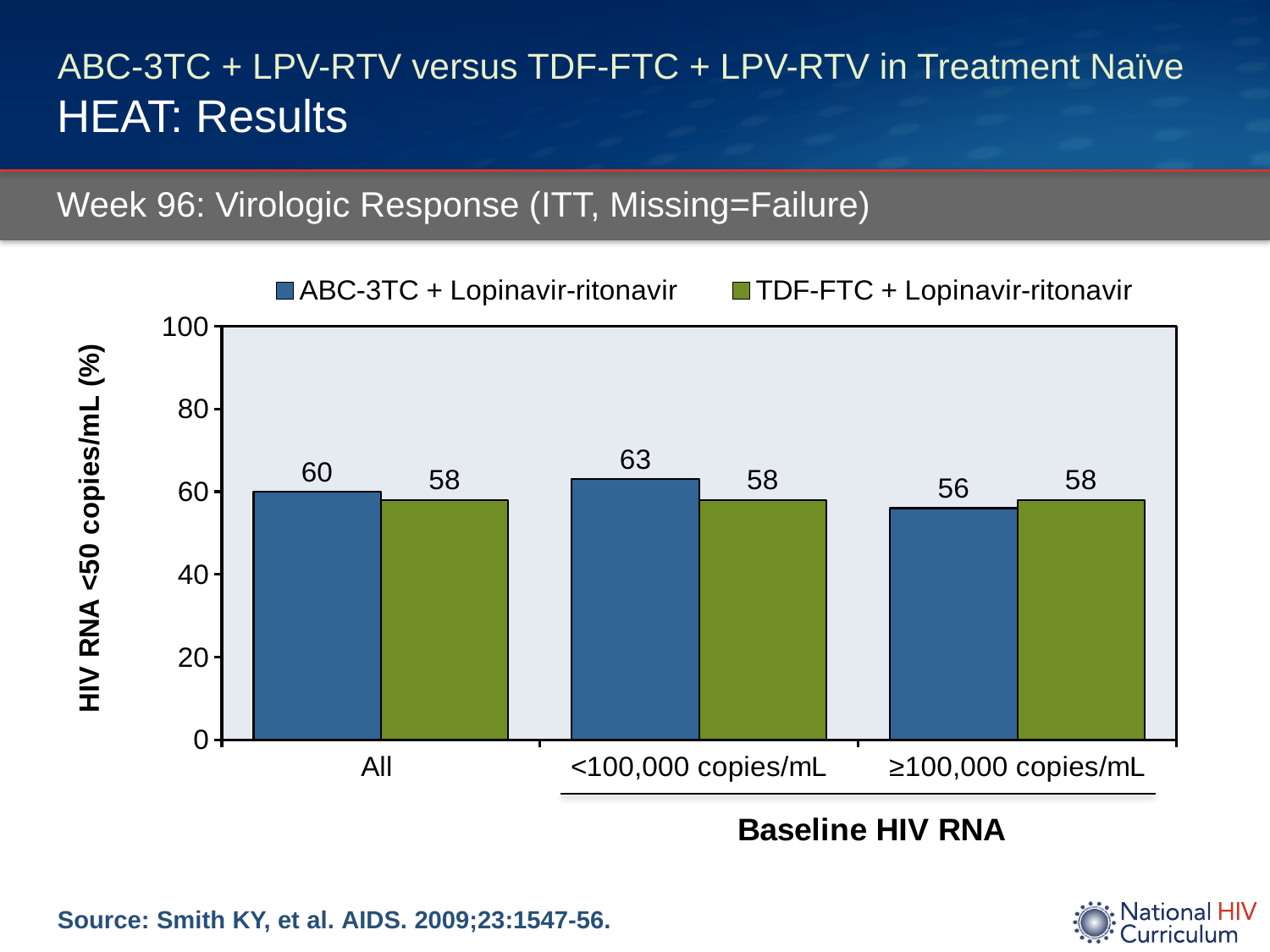
How many series does the legend list? 2 Which category has the highest value for ABC-3TC + Lopinavir-ritonavir? <100,000 copies/mL What is the label of the y axis? HIV RNA <50 copies/mL (%) What is the value for ABC-3TC + Lopinavir-ritonavir in the ≥100,000 copies/mL category? 56 Which category has the lowest value for ABC-3TC + Lopinavir-ritonavir? ≥100,000 copies/mL What is the difference between the ABC-3TC + Lopinavir-ritonavir and TDF-FTC + Lopinavir-ritonavir values in the <100,000 copies/mL category? 5 What is the value for ABC-3TC + Lopinavir-ritonavir in the All category? 60 What is the value for TDF-FTC + Lopinavir-ritonavir in the <100,000 copies/mL category? 58 Is the value for ABC-3TC + Lopinavir-ritonavir in the All category greater or less than 80? less In the ≥100,000 copies/mL category, which series has the larger value? TDF-FTC + Lopinavir-ritonavir How many categories are shown on the x axis? 3 What kind of chart is shown on the slide? bar chart